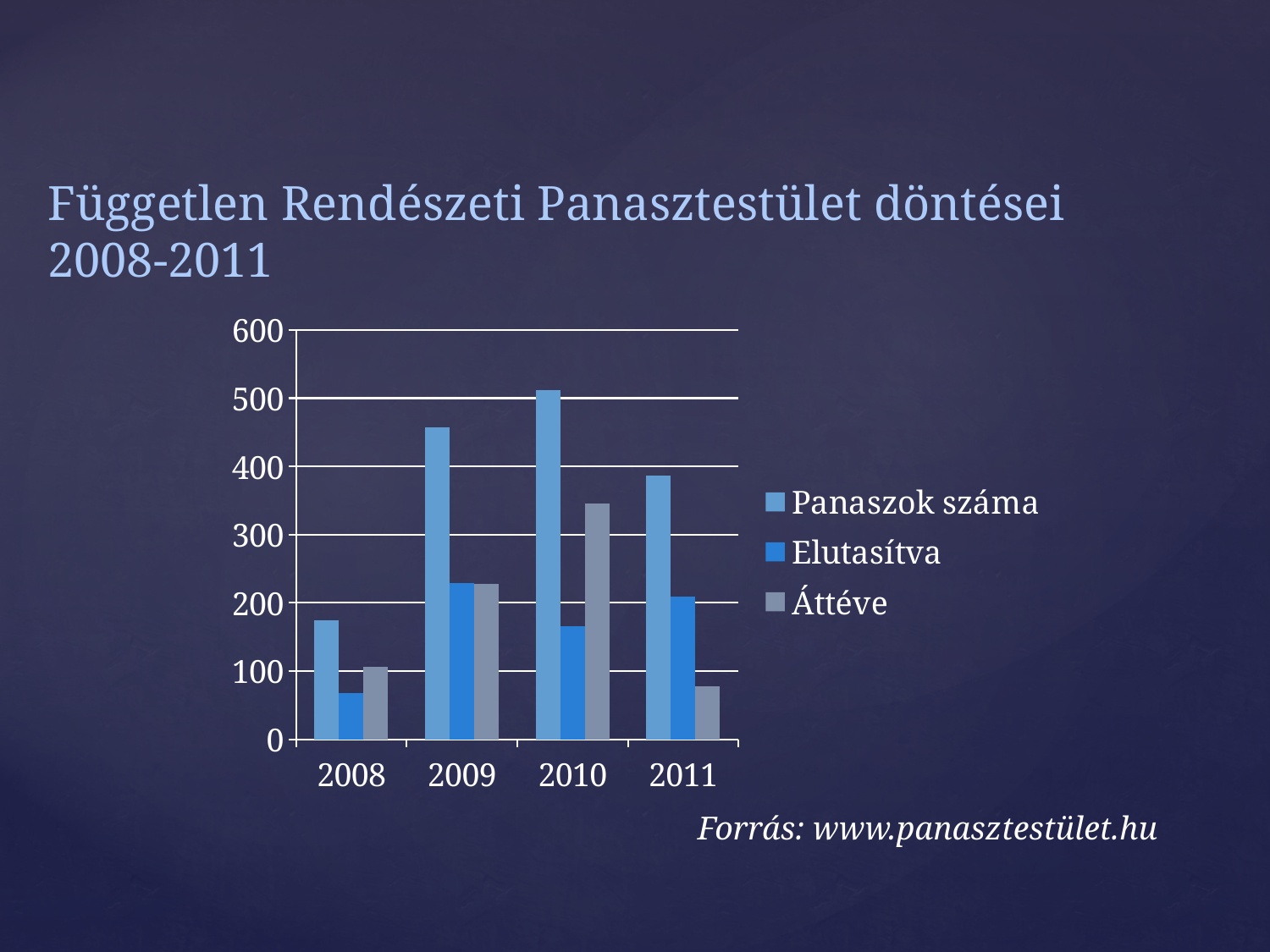
In which year is Panaszok száma lowest? 2008 Which is larger in 2011: Elutasítva or Áttéve? Elutasítva Which is larger: Elutasítva in 2009 or Elutasítva in 2010? 2009 In which year is Panaszok száma highest? 2010 Is the value for Panaszok száma in 2010 greater or less than 400? greater Is the value for Panaszok száma in 2008 greater or less than 200? less In which year is Áttéve highest? 2010 What is the title of the chart on the slide? Független Rendészeti Panasztestület döntései 2008-2011 Is the value for Áttéve in 2010 greater or less than 300? greater How many series does the legend list? 3 What kind of chart is shown on the slide? bar chart How many years are shown on the x axis? 4